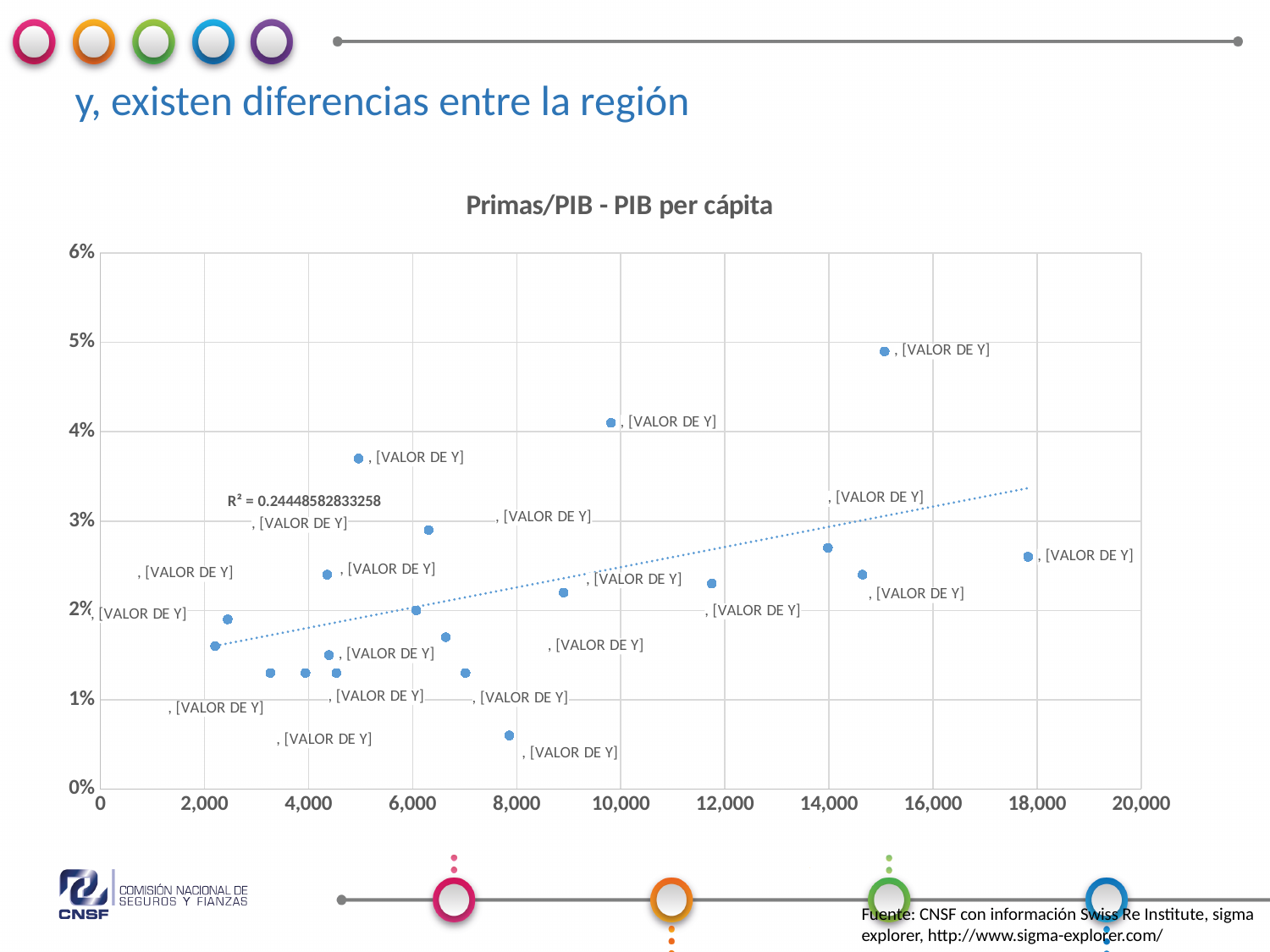
How many data points are plotted on the chart? 20 What kind of chart is shown on the slide? scatter chart What is the title of the chart? Primas/PIB - PIB per cápita What is the highest value shown on the horizontal axis? 20,000 What is the highest value shown on the vertical axis? 6% How many plotted points lie above the 4% gridline? 2 Is the highest plotted point on the chart greater or less than 4%? greater How many plotted points lie above the 3% gridline? 3 What R² value is printed on the chart? R² = 0.24448582833258 Does the dotted trendline rise or fall as the x-axis values increase? rise Is the point with the largest x value (near 18,000) greater or less than 3% on the vertical axis? less Is the lowest plotted point on the chart greater or less than 1%? less